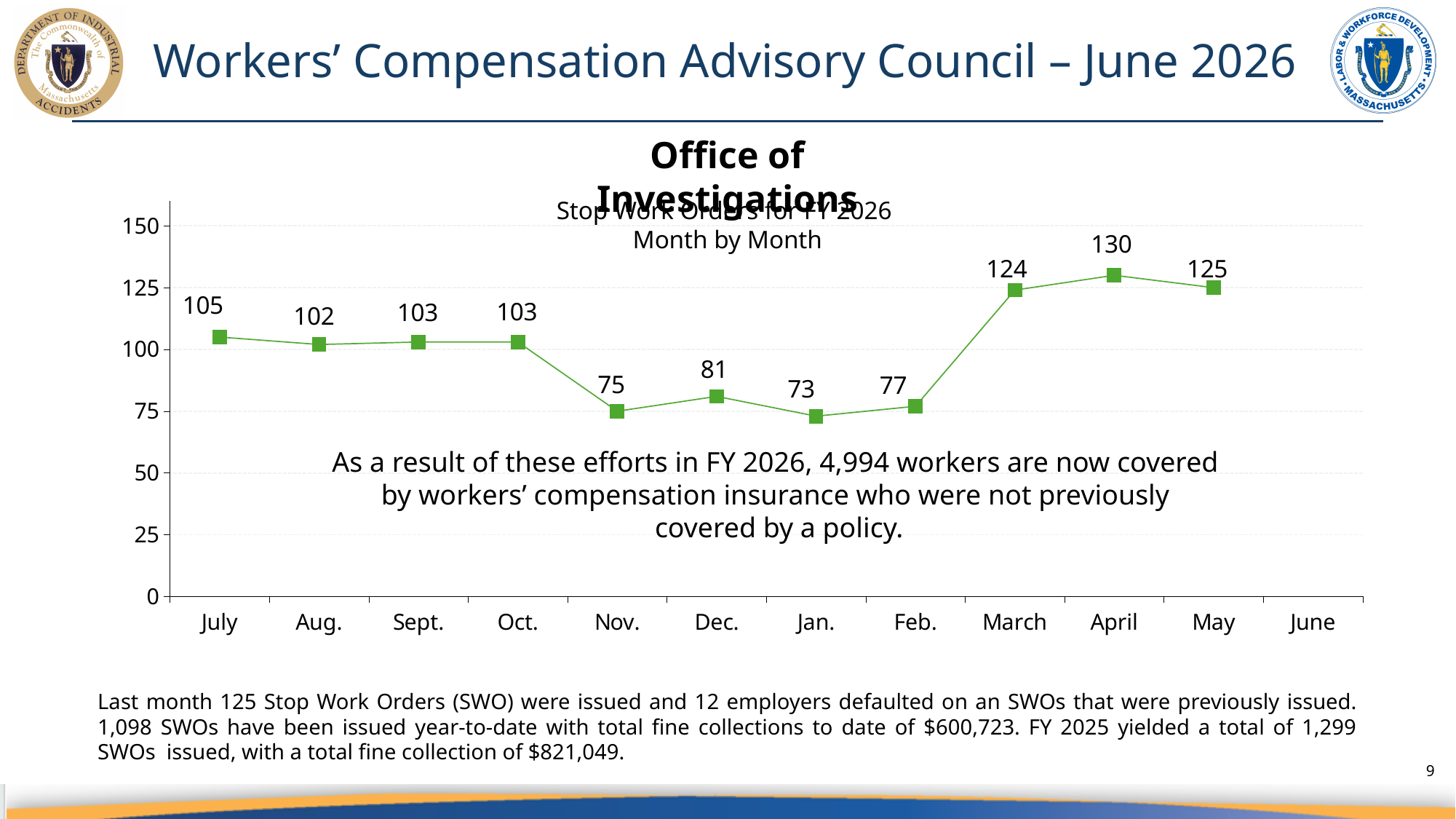
What is the value for July in the Stop Work Orders chart? 105 What kind of chart is used to show Stop Work Orders for FY 2026? line chart What is the value for April in the Stop Work Orders chart? 130 What is the value for Jan. in the Stop Work Orders chart? 73 Which month has the lowest plotted value in the Stop Work Orders chart? Jan. Is the value for May in the Stop Work Orders chart greater or less than 100? greater What is the difference between the values for March and Feb. in the Stop Work Orders chart? 47 What is the difference between the values for April and Jan. in the Stop Work Orders chart? 57 How many months have a plotted data point in the Stop Work Orders chart? 11 Which month has the highest value in the Stop Work Orders chart? April Which is larger in the Stop Work Orders chart, the value for Dec. or the value for Nov.? Dec. Do the values in the Stop Work Orders chart rise or fall from Oct. to Nov.? fall